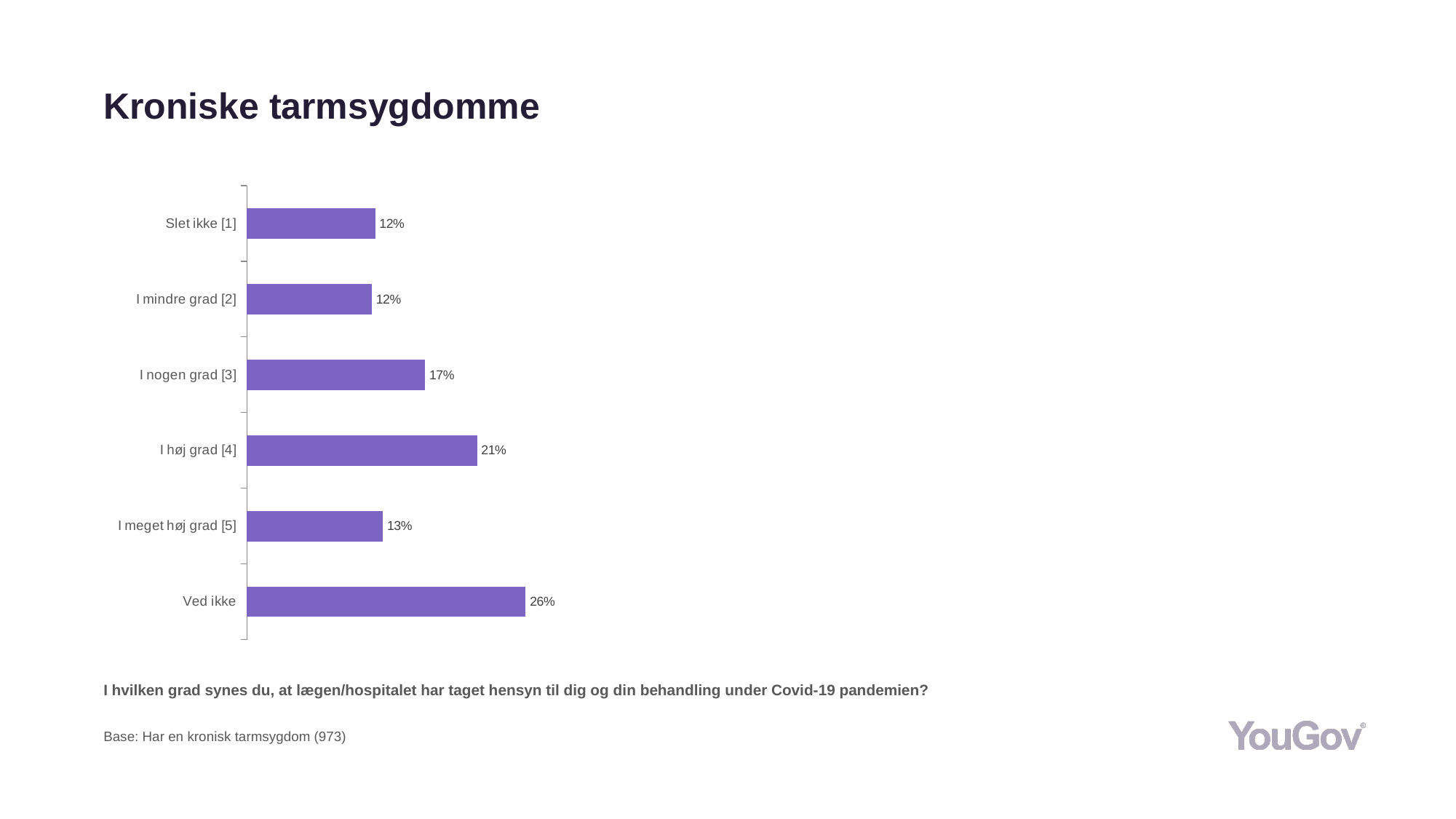
What is the value for 'I høj grad [4]'? 21% Which category has the highest value? Ved ikke What is the value for 'I meget høj grad [5]'? 13% What is the difference between 'I nogen grad [3]' and 'Slet ikke [1]'? 5% What kind of chart is shown on the slide? Bar chart What is the base size stated on the slide? 973 What is the value for 'I nogen grad [3]'? 17% How many categories are shown in the chart? 6 Which is larger, 'I høj grad [4]' or 'I meget høj grad [5]'? I høj grad [4] What is the difference between 'Ved ikke' and 'I høj grad [4]'? 5% What is the value for 'Ved ikke'? 26% What is the title of the slide? Kroniske tarmsygdomme